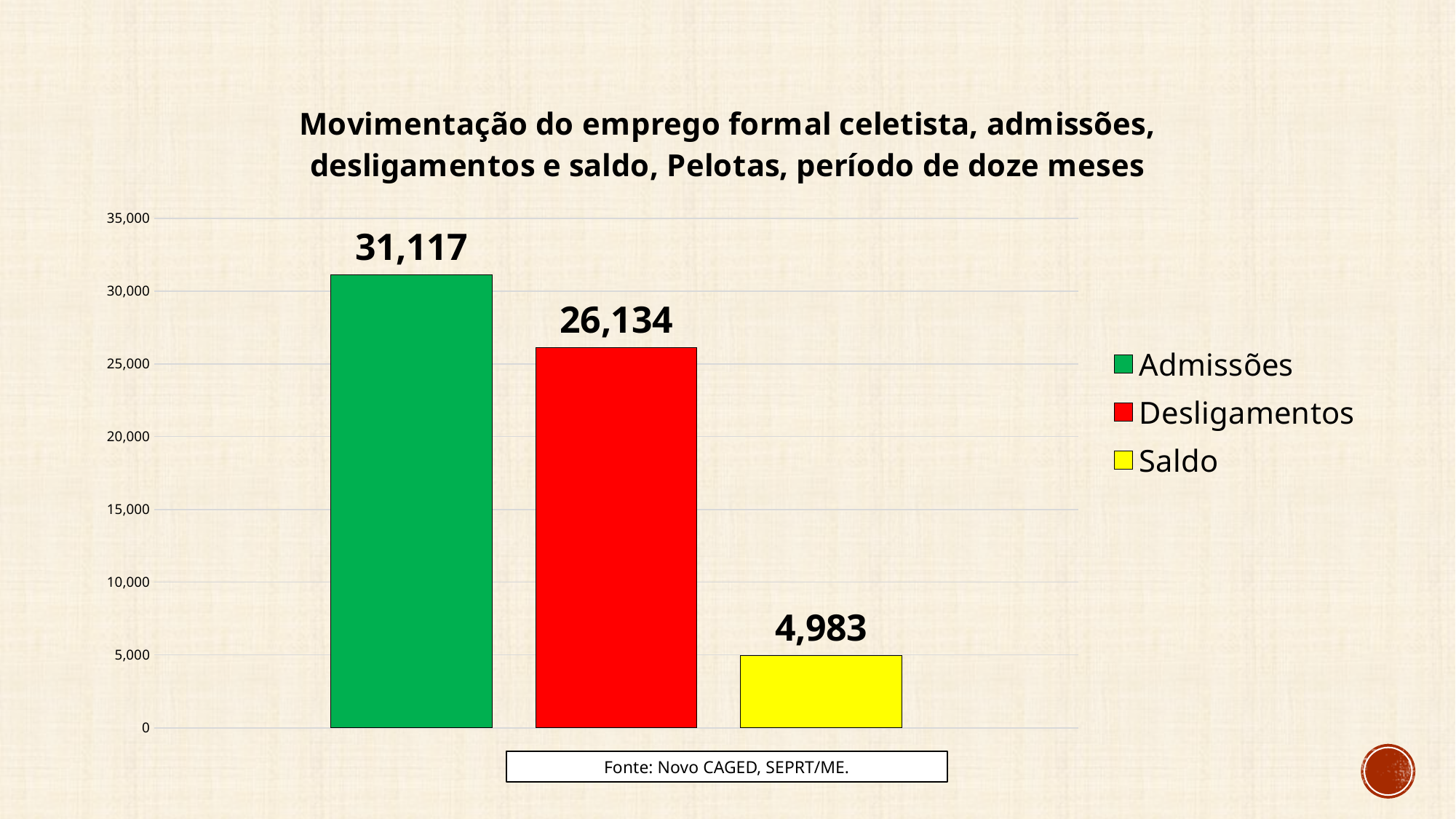
What is the value for Saldo? 4,983 Which series has the lowest value? Saldo What is the value for Admissões? 31,117 What colour is the bar for Saldo? yellow Which series has the highest value? Admissões Which is larger, Desligamentos or Saldo? Desligamentos What kind of chart is shown on the slide? bar chart How many bars are plotted in the chart? 3 Is the value for Desligamentos greater or less than 25,000? greater What is the difference between Admissões and Desligamentos? 4,983 How many series does the legend list? 3 What is the value for Desligamentos? 26,134